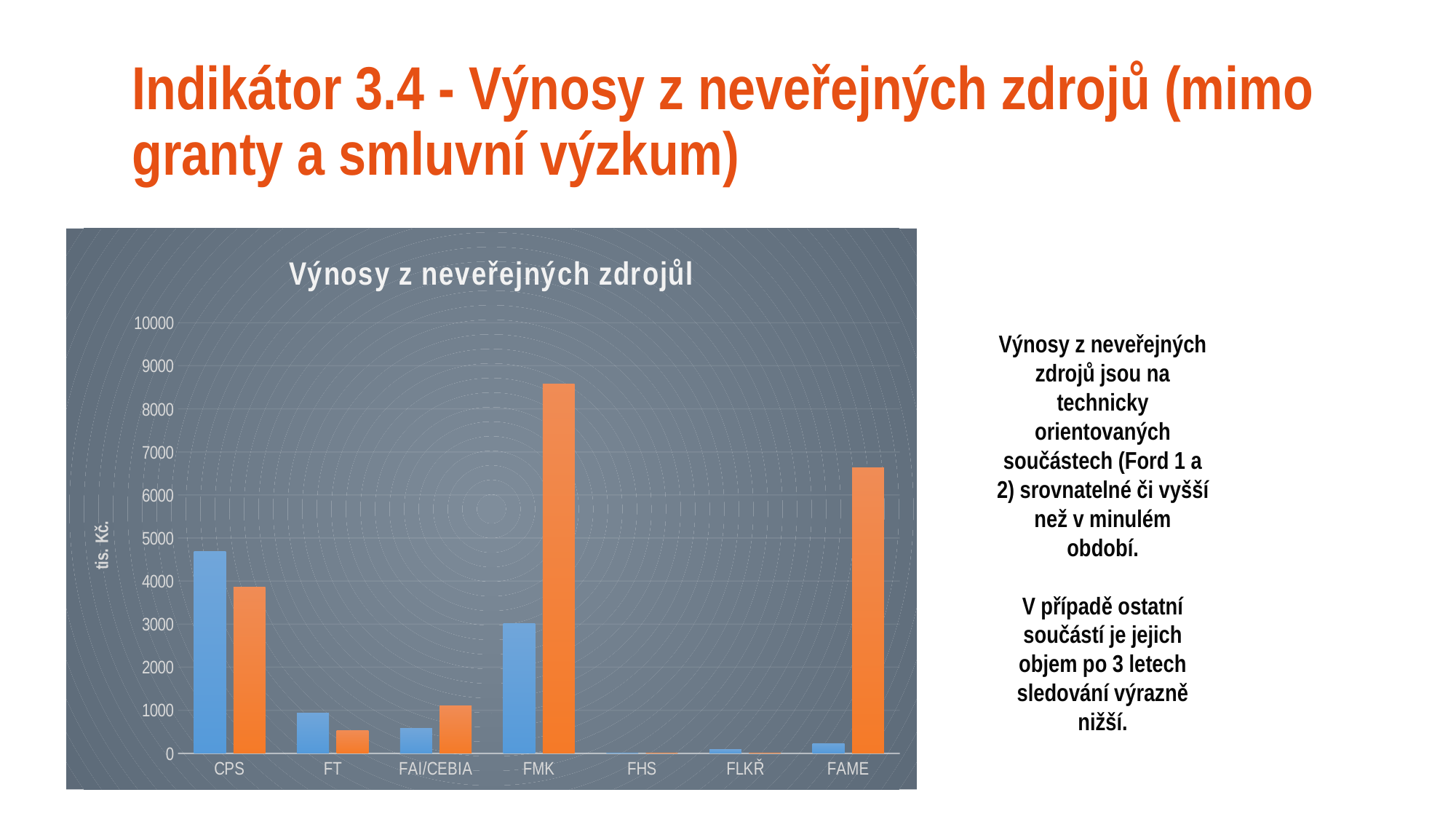
Which category has the tallest blue bar? CPS What is the title of the chart? Výnosy z neveřejných zdrojůl What is the label on the vertical axis of the chart? tis. Kč. What kind of chart is shown on the slide? bar chart Is the orange bar for FAME greater or less than 7000? less For CPS, which bar is taller, the blue one or the orange one? blue Which category has the tallest orange bar? FMK How many categories are shown on the x axis of the chart? 7 Is the orange bar for FMK greater or less than 8000? greater How many bars are plotted for each category in the chart? 2 Is the blue bar for CPS greater or less than 4000? greater For FAI/CEBIA, which bar is taller, the blue one or the orange one? orange